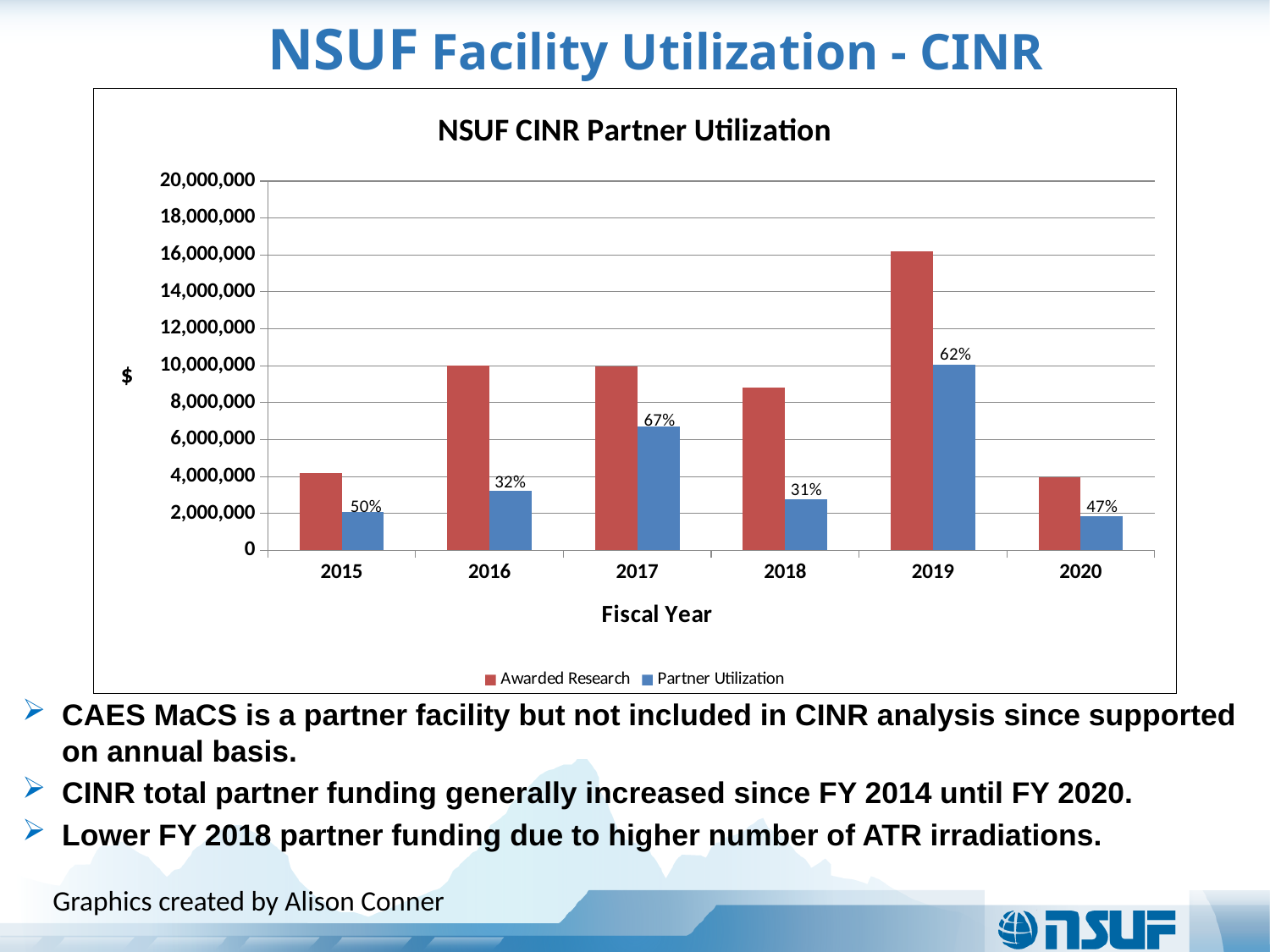
Is the Awarded Research value for 2019 greater or less than 14,000,000? greater Which is larger, the Awarded Research value for 2018 or the Awarded Research value for 2019? 2019 What percentage label is shown on the Partner Utilization bar for 2015? 50% In which fiscal year is the Awarded Research value highest? 2019 How many fiscal years are shown on the x axis? 6 What percentage label is shown on the Partner Utilization bar for 2018? 31% Is the Partner Utilization value for 2016 greater or less than 4,000,000? less How many series does the legend list? 2 What percentage label is shown on the Partner Utilization bar for 2017? 67% In which fiscal year is the Partner Utilization value highest? 2019 What is the title of the chart? NSUF CINR Partner Utilization What type of chart is shown on the slide? bar chart